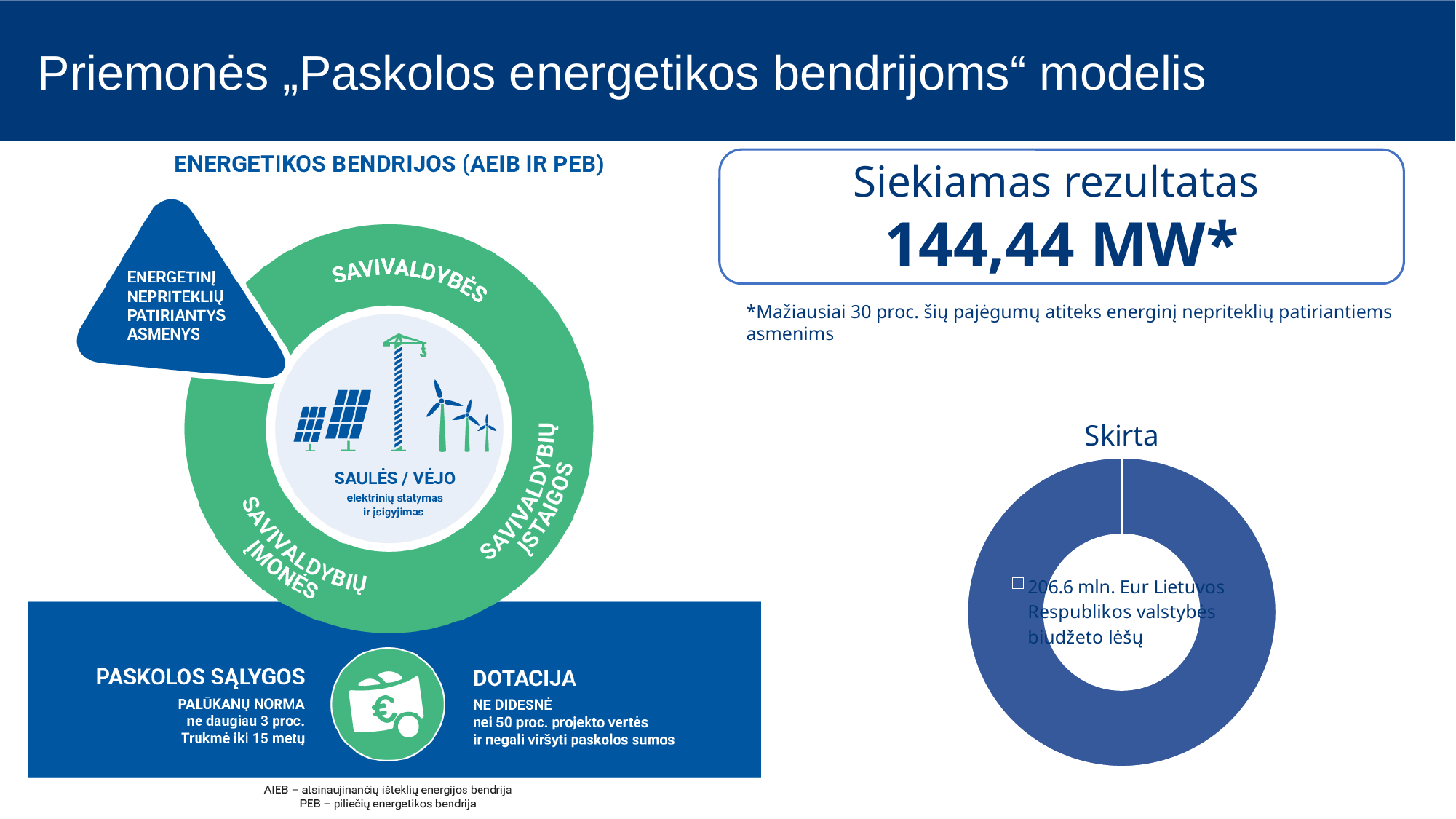
What is the title of the chart on the right side of the slide? Skirta What amount in mln. Eur is named in the legend of the "Skirta" chart? 206.6 mln. Eur What kind of chart is shown under the heading "Skirta"? doughnut (pie) chart How many slices does the "Skirta" doughnut chart contain? 1 What share of the "Skirta" doughnut chart does the single slice occupy? 100% What does the legend entry of the "Skirta" chart say? 206.6 mln. Eur Lietuvos Respublikos valstybės biudžeto lėšų How many entries does the legend of the "Skirta" chart list? 1